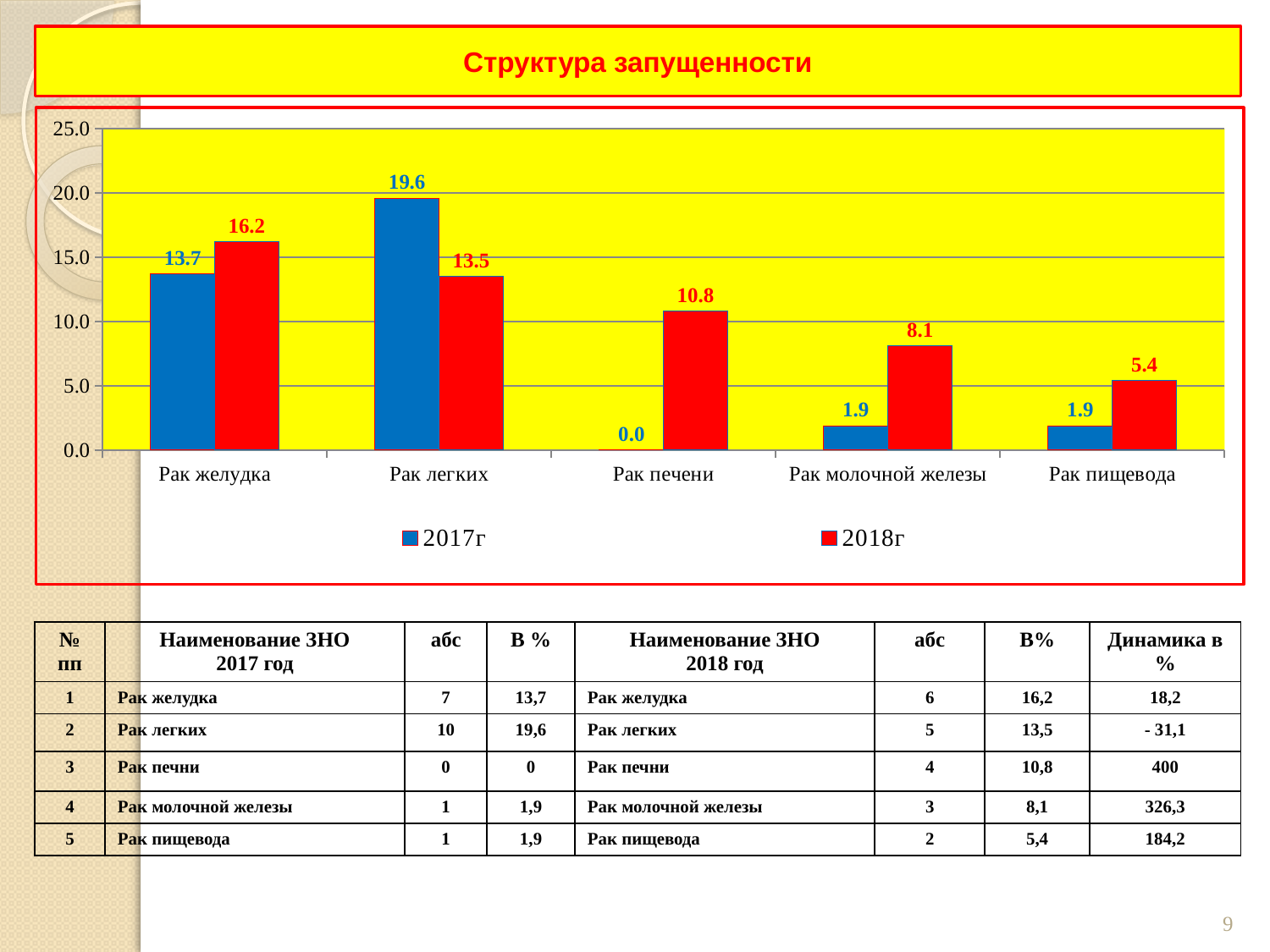
Is the 2018г value for Рак пищевода greater or less than 10.0? less What is the value for Рак молочной железы in the 2018г series? 8.1 Which is larger for Рак легких: the 2017г value or the 2018г value? 2017г How many series does the chart legend list? 2 What is the value for Рак легких in the 2017г series? 19.6 What is the value for Рак печени in the 2018г series? 10.8 What type of chart is shown on the slide? bar chart What is the difference between the 2018г and 2017г values for Рак желудка? 2.5 How many categories are shown on the x axis of the chart? 5 What is the title of the slide above the chart? Структура запущенности Which category has the highest value in the 2018г series? Рак желудка Which category has the lowest value in the 2017г series? Рак печени